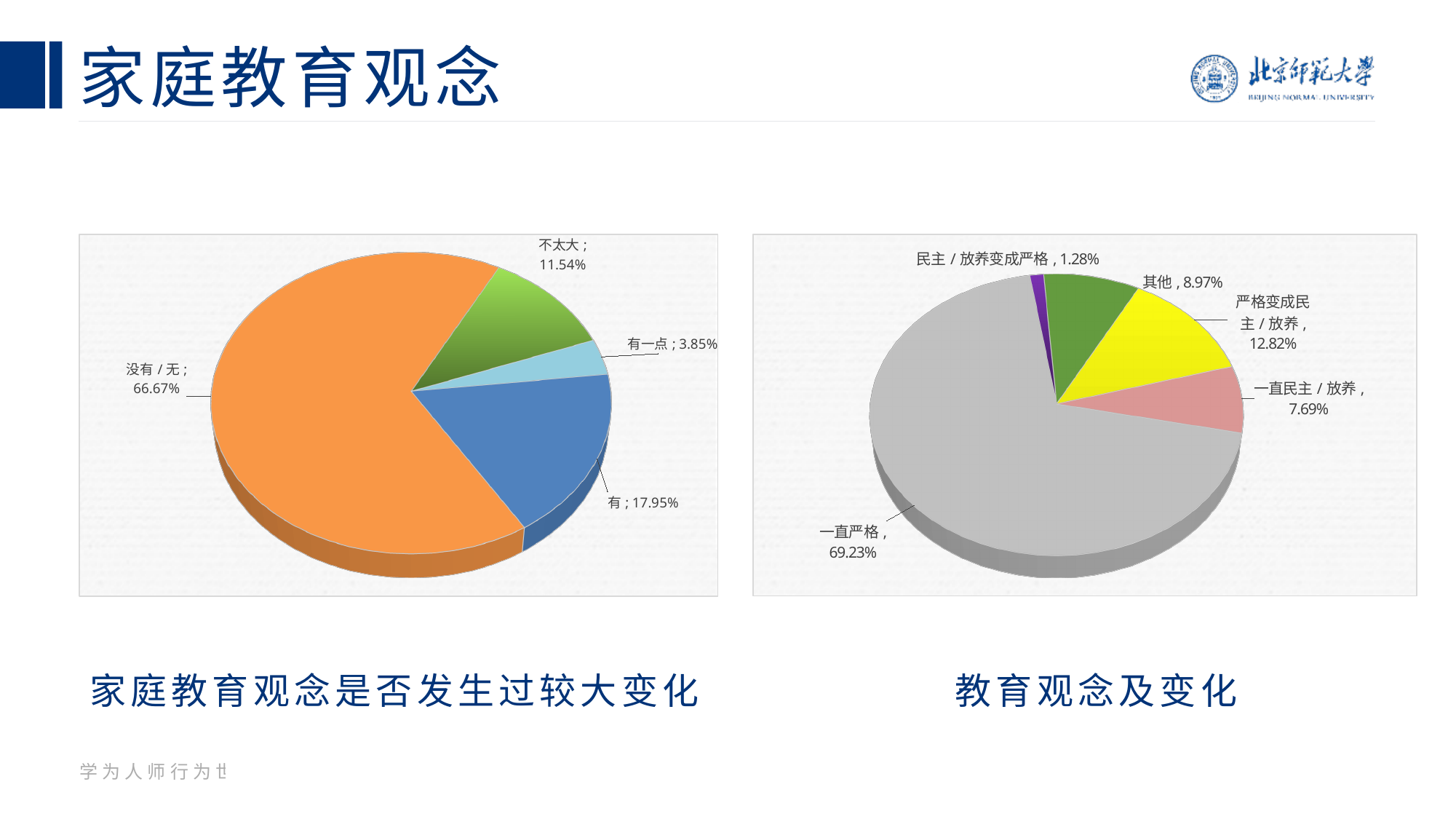
What kind of chart is the left chart (家庭教育观念是否发生过较大变化)? Pie chart In the left chart (家庭教育观念是否发生过较大变化), what is the difference between 不太大 and 有一点? 7.69% In the left chart (家庭教育观念是否发生过较大变化), what is the value for 没有/无? 66.67% In the left chart (家庭教育观念是否发生过较大变化), which category has the smallest share? 有一点 In the right chart (教育观念及变化), what is the value for 严格变成民主/放养? 12.82% In the left chart (家庭教育观念是否发生过较大变化), what is the value for 有? 17.95% In the right chart (教育观念及变化), which is larger, 其他 or 一直民主/放养? 其他 In the right chart (教育观念及变化), how many slices does the pie have? 5 In the right chart (教育观念及变化), what colour is the 一直严格 slice? Grey In the left chart (家庭教育观念是否发生过较大变化), how many slices does the pie have? 4 In the right chart (教育观念及变化), what is the value for 一直严格? 69.23% In the right chart (教育观念及变化), which category has the smallest share? 民主/放养变成严格